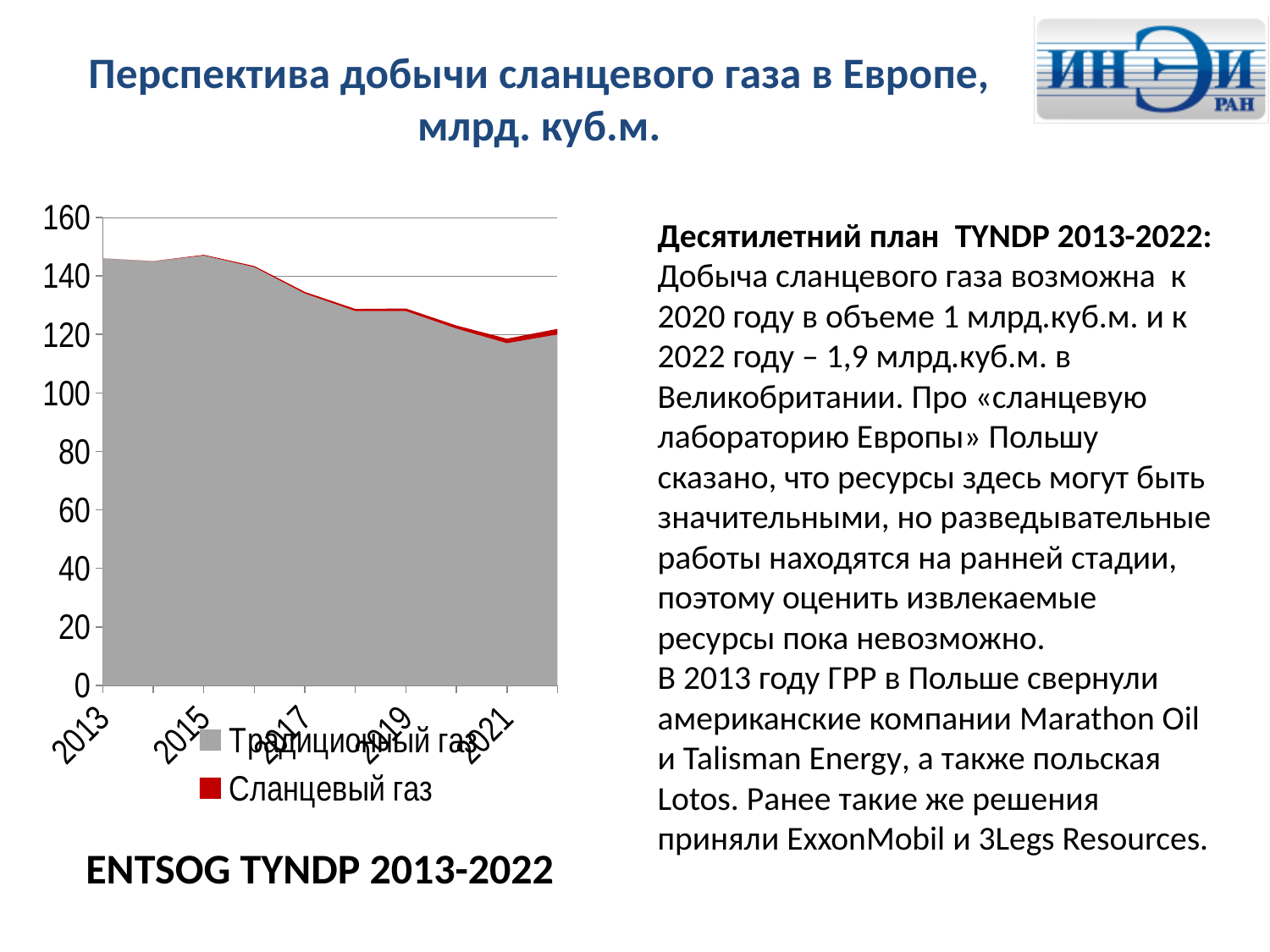
Is the total value for 2021 greater or less than 140? less Does the total gas production in the chart rise or fall from 2013 to 2021? Fall How many series does the chart legend list? 2 Is the total value for 2013 greater or less than 140? greater What colour represents Сланцевый газ in the chart? Red How many year labels are shown on the x axis of the chart? 5 Which year has the larger total value, 2013 or 2021? 2013 Which series is larger in 2021, Традиционный газ or Сланцевый газ? Традиционный газ What kind of chart is shown on the slide? Area chart Is the total value for 2019 greater or less than 120? greater Which two series are listed in the chart legend? Традиционный газ and Сланцевый газ